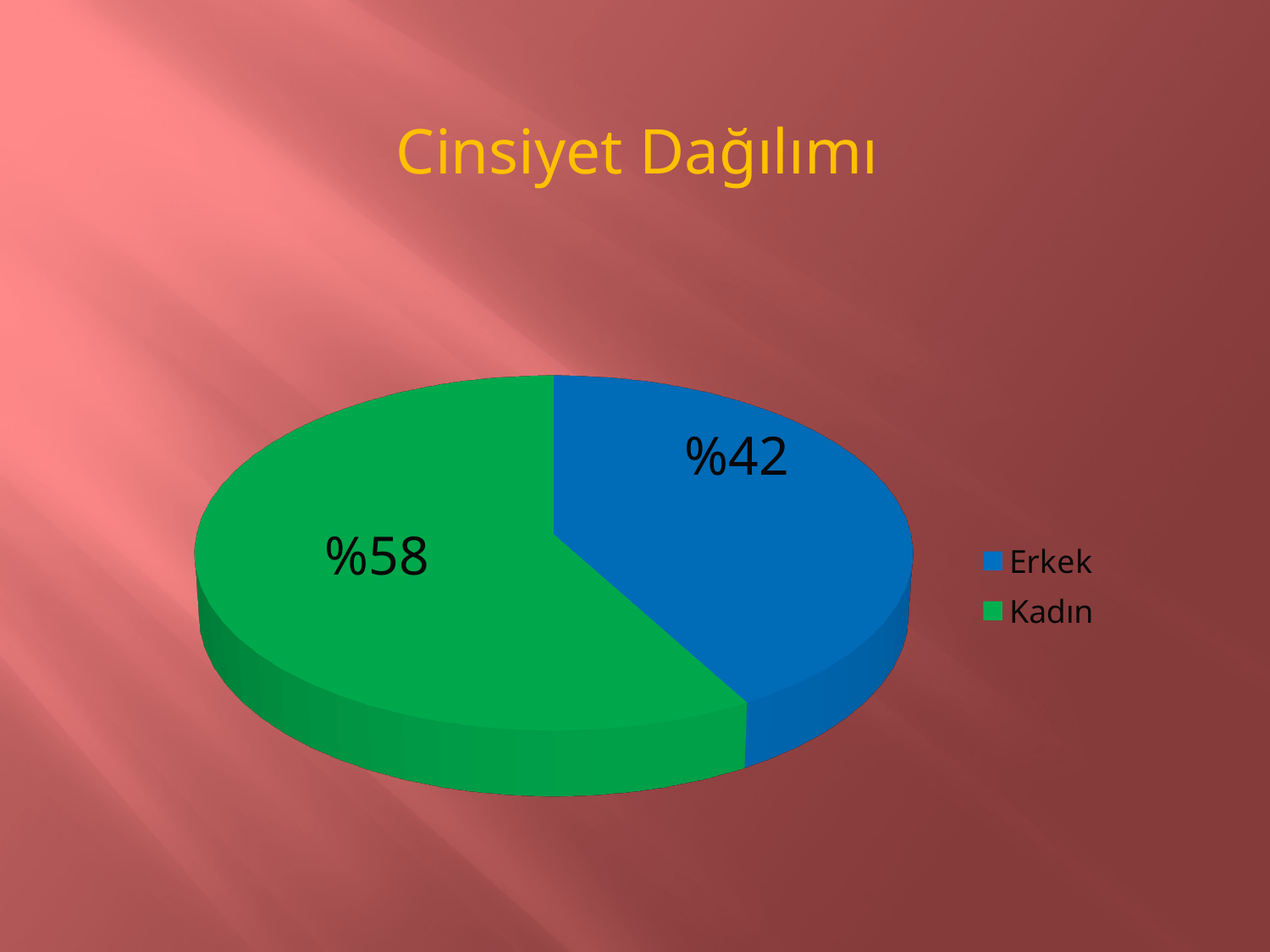
What is the title of the chart? Cinsiyet Dağılımı How many entries does the legend list? 2 What is the value shown for Erkek? %42 Which category has the largest share of the pie? Kadın What colour is the Kadın slice? green What is the value shown for Kadın? %58 Which category has the smallest share of the pie? Erkek What kind of chart is shown on the slide? pie chart What share of the pie does Erkek represent? %42 How many slices does the pie chart have? 2 Which is larger, the share for Erkek or the share for Kadın? Kadın What is the difference between the Kadın share and the Erkek share? 16 percentage points